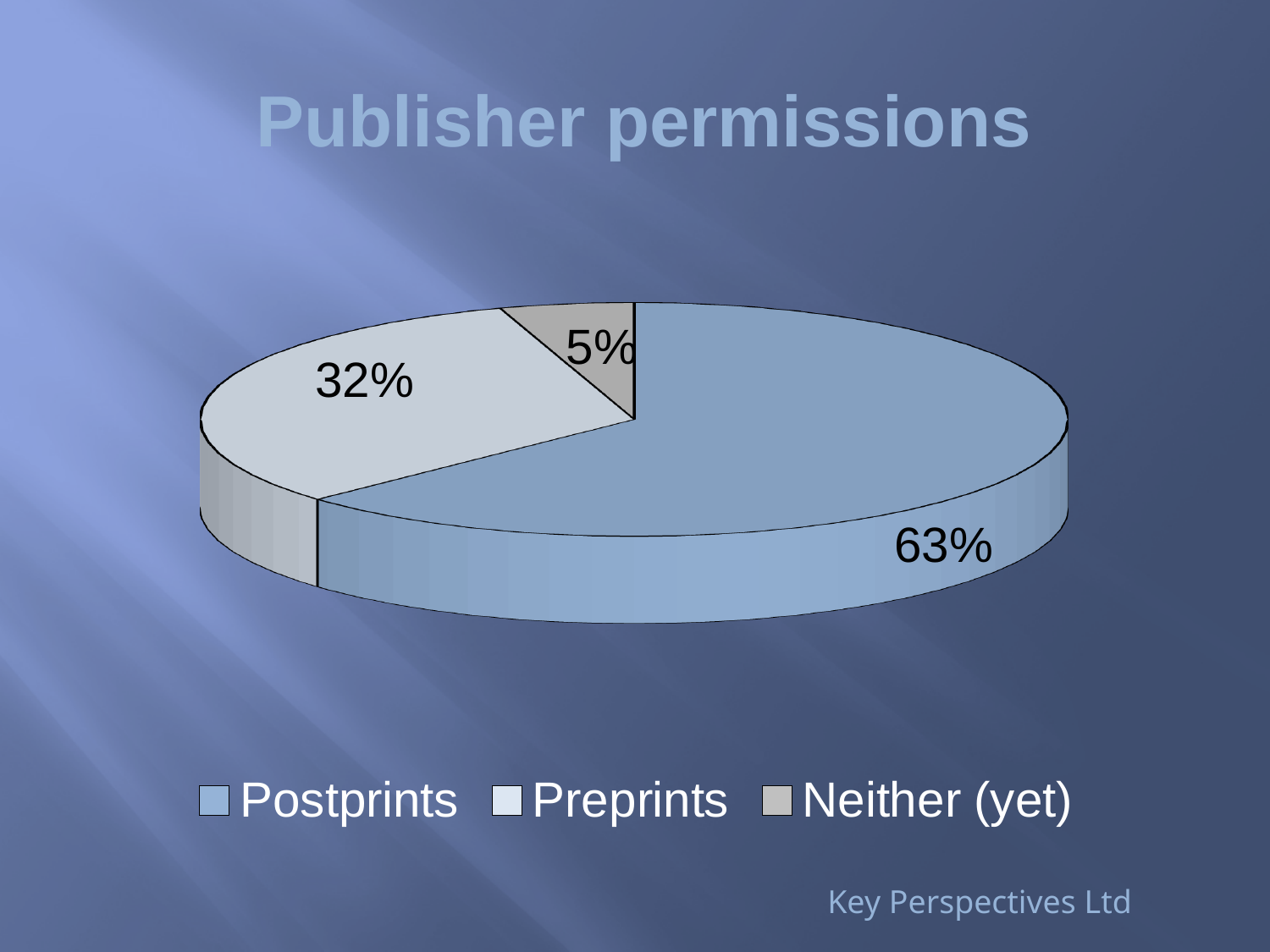
What is the title of the slide? Publisher permissions What is the difference in percentage points between Postprints and Preprints? 31 What share of the pie does Preprints have? 32% What share of the pie does Postprints have? 63% Which is larger, the Preprints slice or the Neither (yet) slice? Preprints Which legend entry is shown in grey? Neither (yet) What kind of chart is shown on the slide? Pie chart Which category has the largest slice of the pie? Postprints Which category has the smallest slice of the pie? Neither (yet) What share of the pie does Neither (yet) have? 5% What is the difference in percentage points between Preprints and Neither (yet)? 27 How many slices does the pie chart have? 3